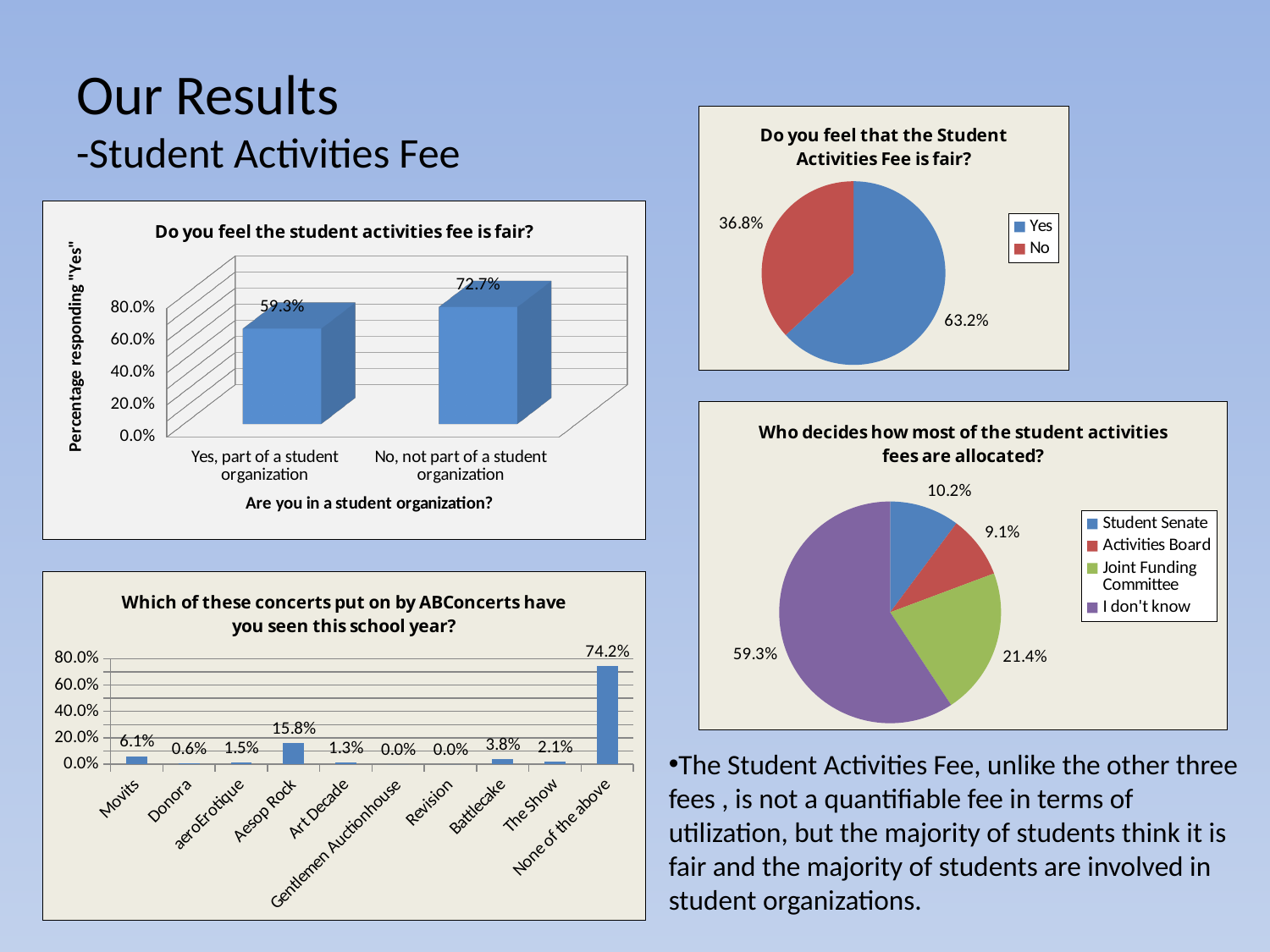
In the bottom-left bar chart about ABConcerts, which is larger: the value for Movits or the value for Battlecake? Movits How many entries does the legend list in the bottom-right pie chart titled "Who decides how most of the student activities fees are allocated?"? 4 In the bottom-left bar chart about ABConcerts, which category has the highest value? None of the above In the top-right pie chart titled "Do you feel that the Student Activities Fee is fair?", what share of respondents answered "No"? 36.8% In the bottom-left bar chart about ABConcerts, what percentage of students saw Aesop Rock? 15.8% In the top-left bar chart titled "Do you feel the student activities fee is fair?", which group has the higher percentage responding "Yes"? No, not part of a student organization In the bottom-left bar chart about ABConcerts, what is the value for Donora? 0.6% In the bottom-right pie chart titled "Who decides how most of the student activities fees are allocated?", what share of respondents chose "Joint Funding Committee"? 21.4% In the bottom-right pie chart titled "Who decides how most of the student activities fees are allocated?", which response has the smallest share? Activities Board In the top-left bar chart titled "Do you feel the student activities fee is fair?", what is the difference between the value for students not in a student organization and those in a student organization? 13.4% In the bottom-left bar chart about ABConcerts, how many categories are shown on the x axis? 10 In the top-left bar chart titled "Do you feel the student activities fee is fair?", what percentage of students who are part of a student organization responded "Yes"? 59.3%